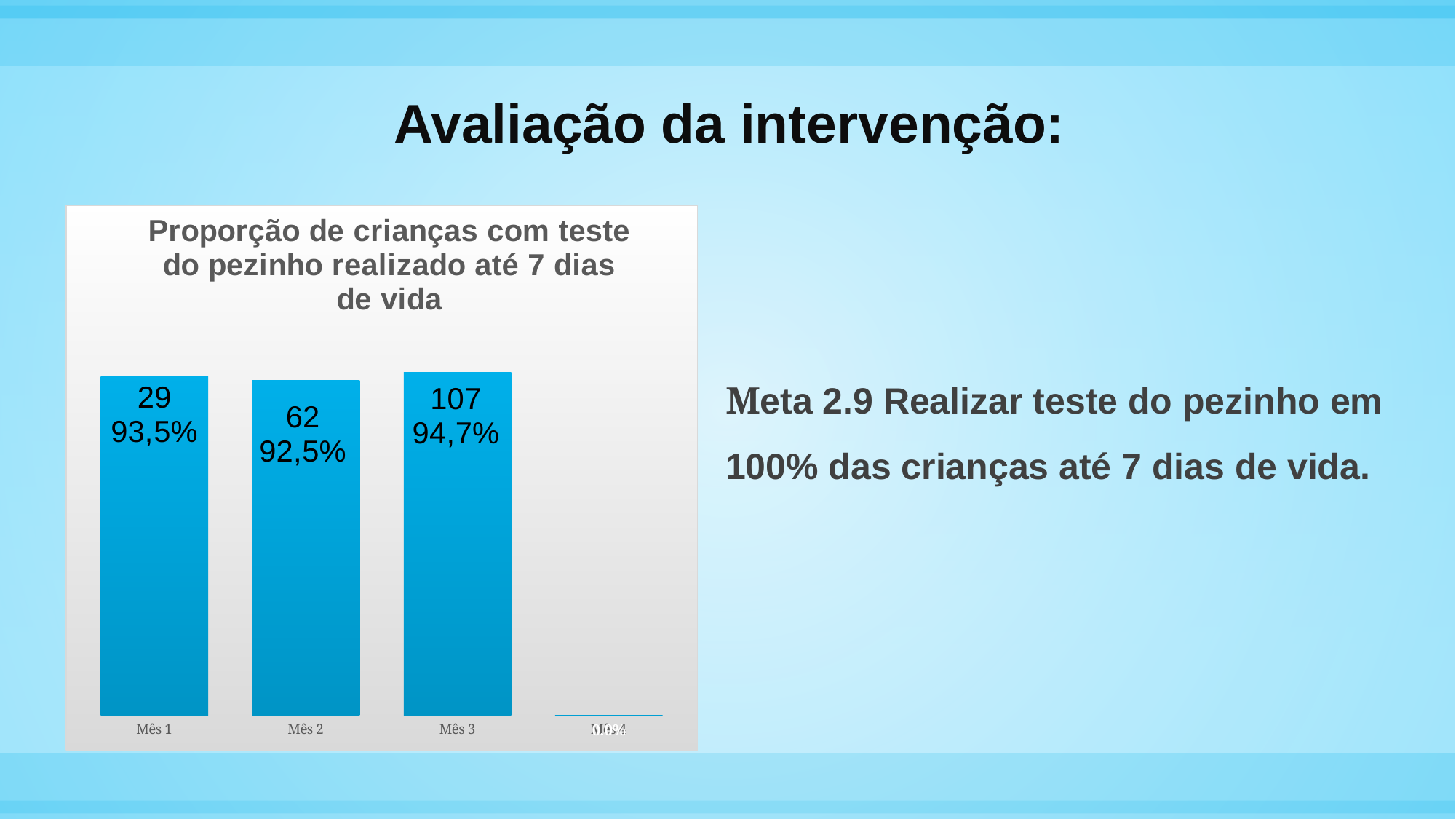
Among Mês 1, Mês 2 and Mês 3, which month has the lowest percentage? Mês 2 What type of chart is shown on the slide? Bar chart What percentage is shown for Mês 3 in the chart? 94,7% What percentage is shown for Mês 1 in the chart? 93,5% How many month categories are labelled on the x axis of the chart? 4 What count is printed on the bar for Mês 1? 29 What count is printed on the bar for Mês 3? 107 What is the difference in percentage points between Mês 3 and Mês 2? 2,2 What is the difference between the counts printed for Mês 3 and Mês 2? 45 What percentage is shown for Mês 2 in the chart? 92,5% Which has a higher percentage, Mês 1 or Mês 2? Mês 1 Which month has the highest percentage in the chart? Mês 3